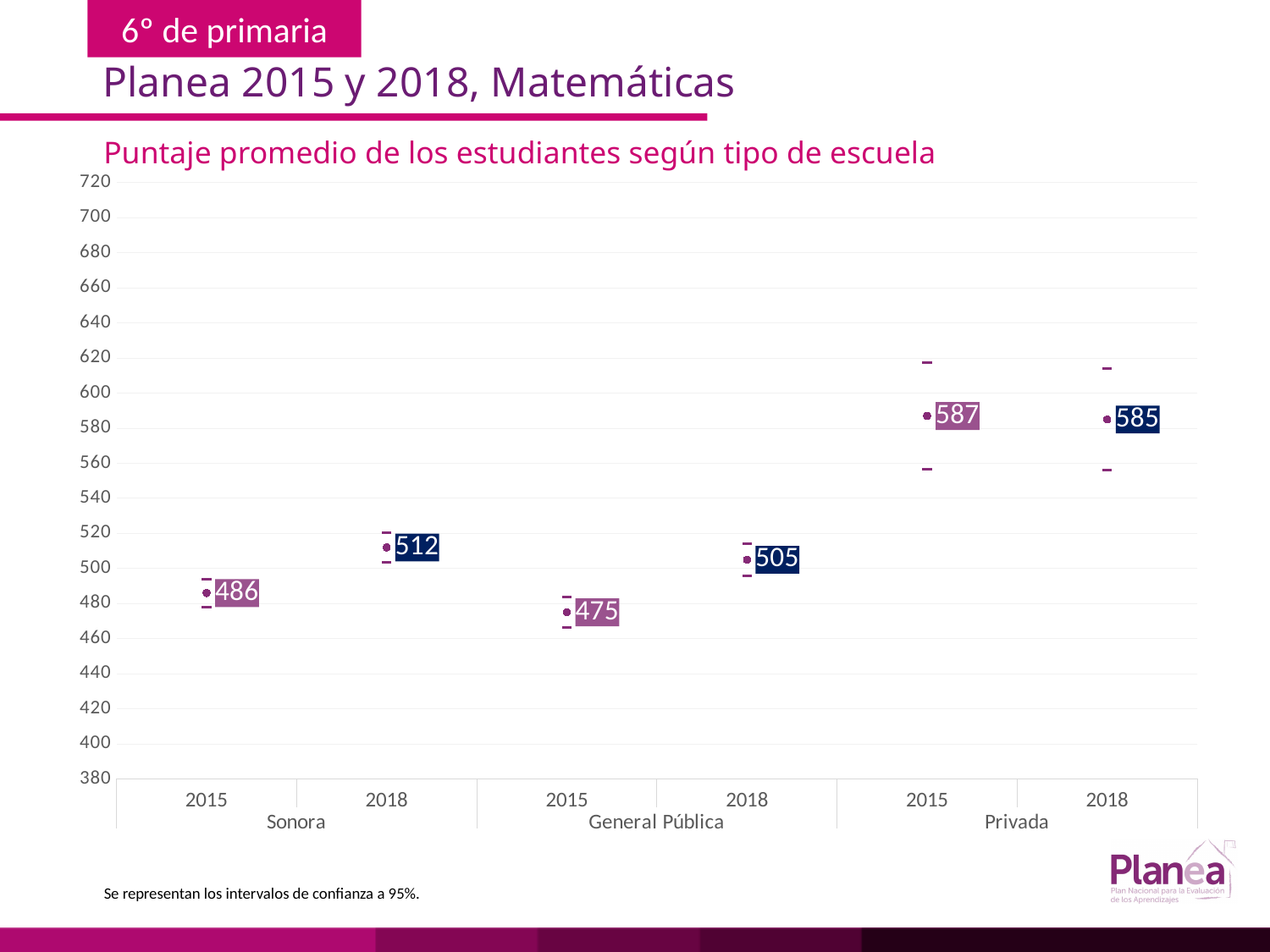
What is the average score for General Pública in 2015? 475 What is the title of the chart? Puntaje promedio de los estudiantes según tipo de escuela What is the difference between the General Pública scores in 2018 and 2015? 30 Which school type and year has the highest average score? Privada 2015 What is the average score for Sonora in 2015? 486 How many data points are plotted on the chart? 6 What is the average score for Sonora in 2018? 512 Which is larger, the Sonora 2018 score or the General Pública 2018 score? Sonora 2018 What is the average score for Privada in 2018? 585 By how many points did the Sonora average score change from 2015 to 2018? 26 Did the Privada average score rise or fall from 2015 to 2018? Fall Which school type and year has the lowest average score? General Pública 2015